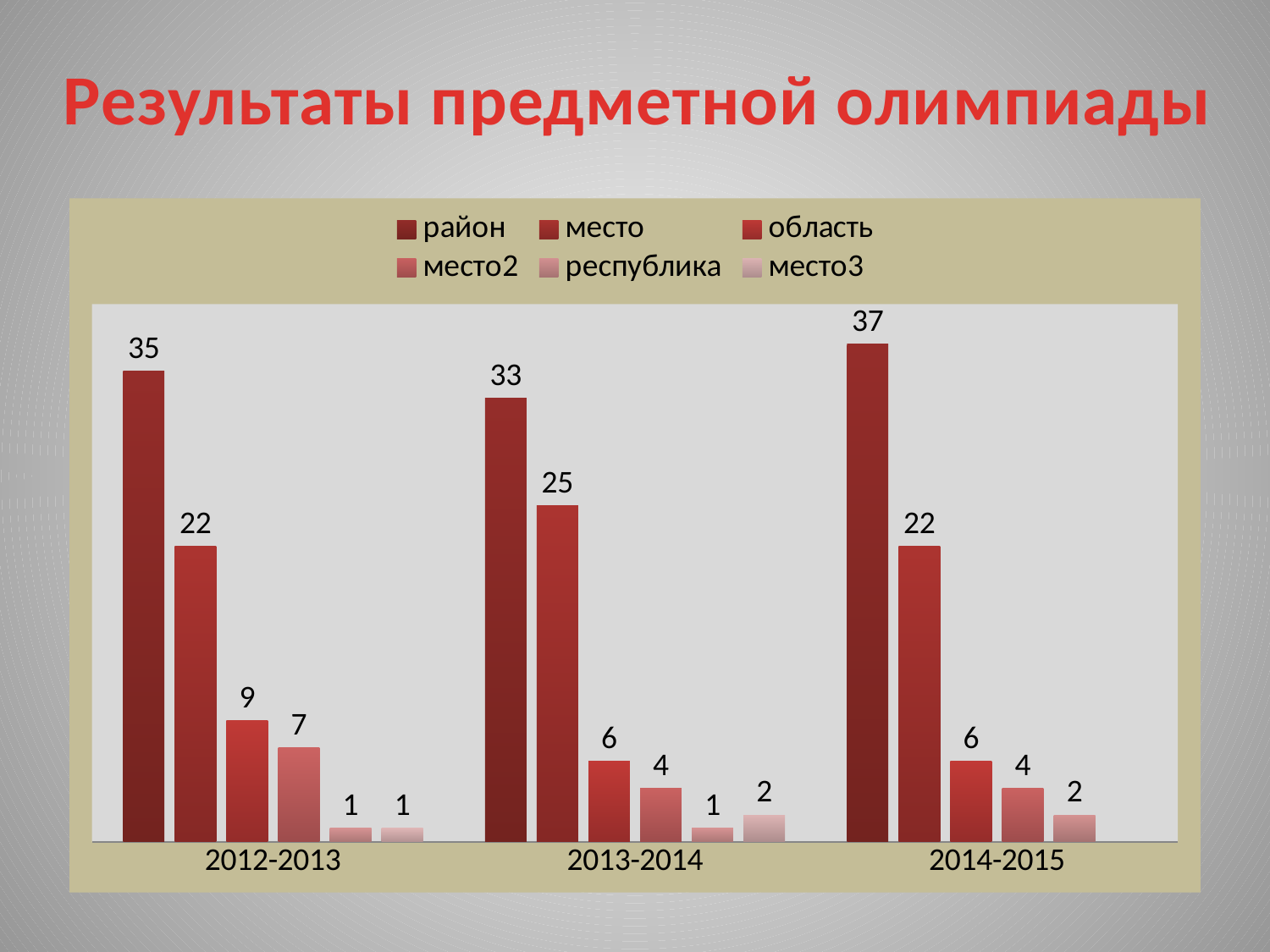
What is the value for место2 in 2014-2015? 4 What is the value for место in 2013-2014? 25 What kind of chart is shown on the slide? Bar chart How many year groups are shown on the x axis? 3 What is the value for район in 2014-2015? 37 What is the title of the slide? Результаты предметной олимпиады In which year group is the район bar lowest? 2013-2014 What is the value for область in 2012-2013? 9 Which is larger: the место value in 2013-2014 or the место value in 2014-2015? 2013-2014 How many series does the legend list? 6 In which year group is the район bar highest? 2014-2015 What is the difference between the район value and the место value in 2012-2013? 13